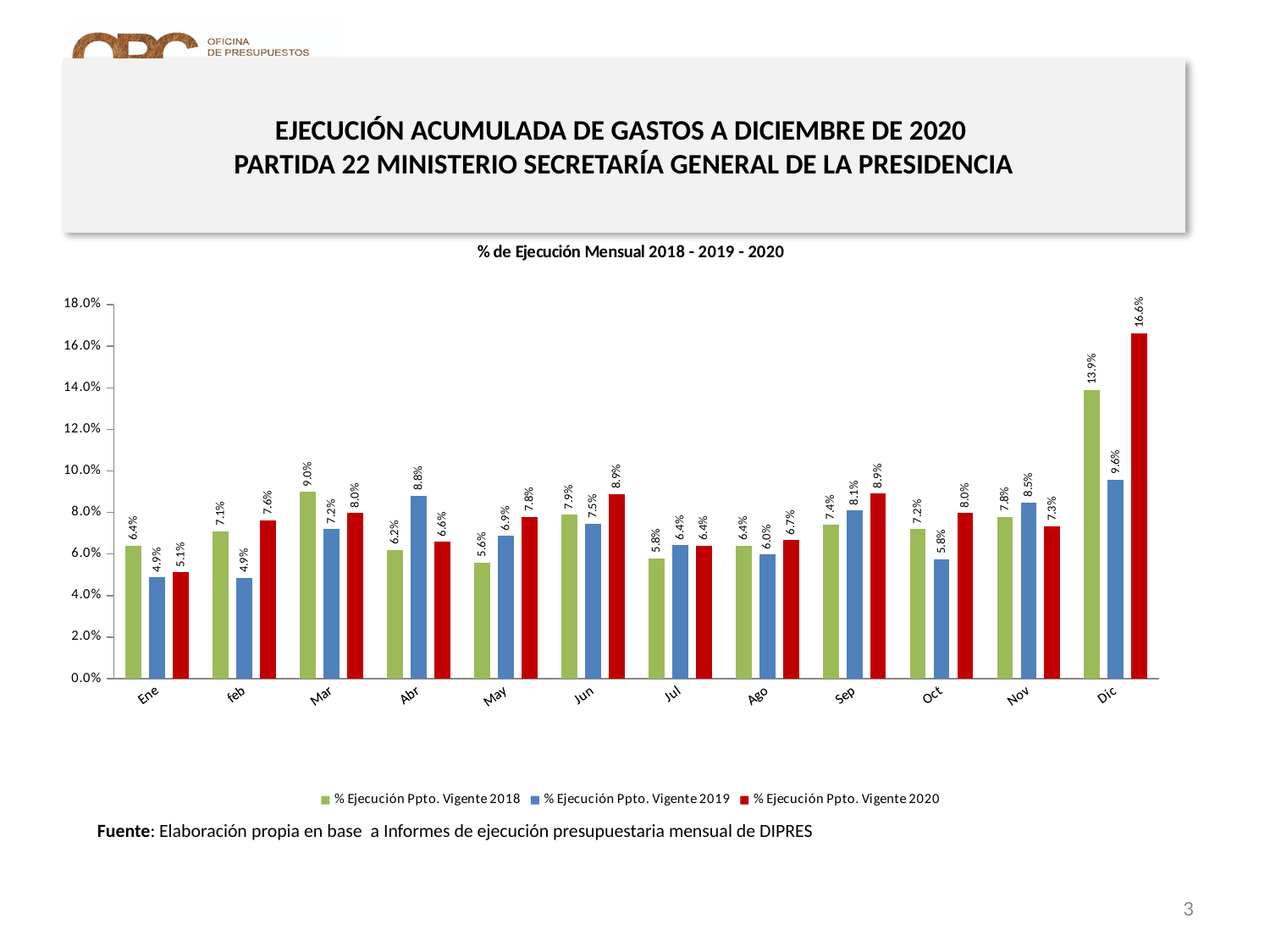
What is the value for % Ejecución Ppto. Vigente 2020 in Dic? 16.6% How many months are shown on the x axis? 12 What is the value for % Ejecución Ppto. Vigente 2019 in Abr? 8.8% What is the difference between the 2020 and 2018 values in Dic? 2.7% Is the value for % Ejecución Ppto. Vigente 2018 in Dic greater or less than 12.0%? greater What kind of chart is shown on the slide? Bar chart Which is larger in Sep: the 2019 value or the 2020 value? 2020 value (8.9%) How many series does the legend list? 3 What is the value for % Ejecución Ppto. Vigente 2018 in Mar? 9.0% What is the title of the chart? % de Ejecución Mensual 2018 - 2019 - 2020 Which month has the highest value for % Ejecución Ppto. Vigente 2019? Dic Which month has the lowest value for % Ejecución Ppto. Vigente 2018? May